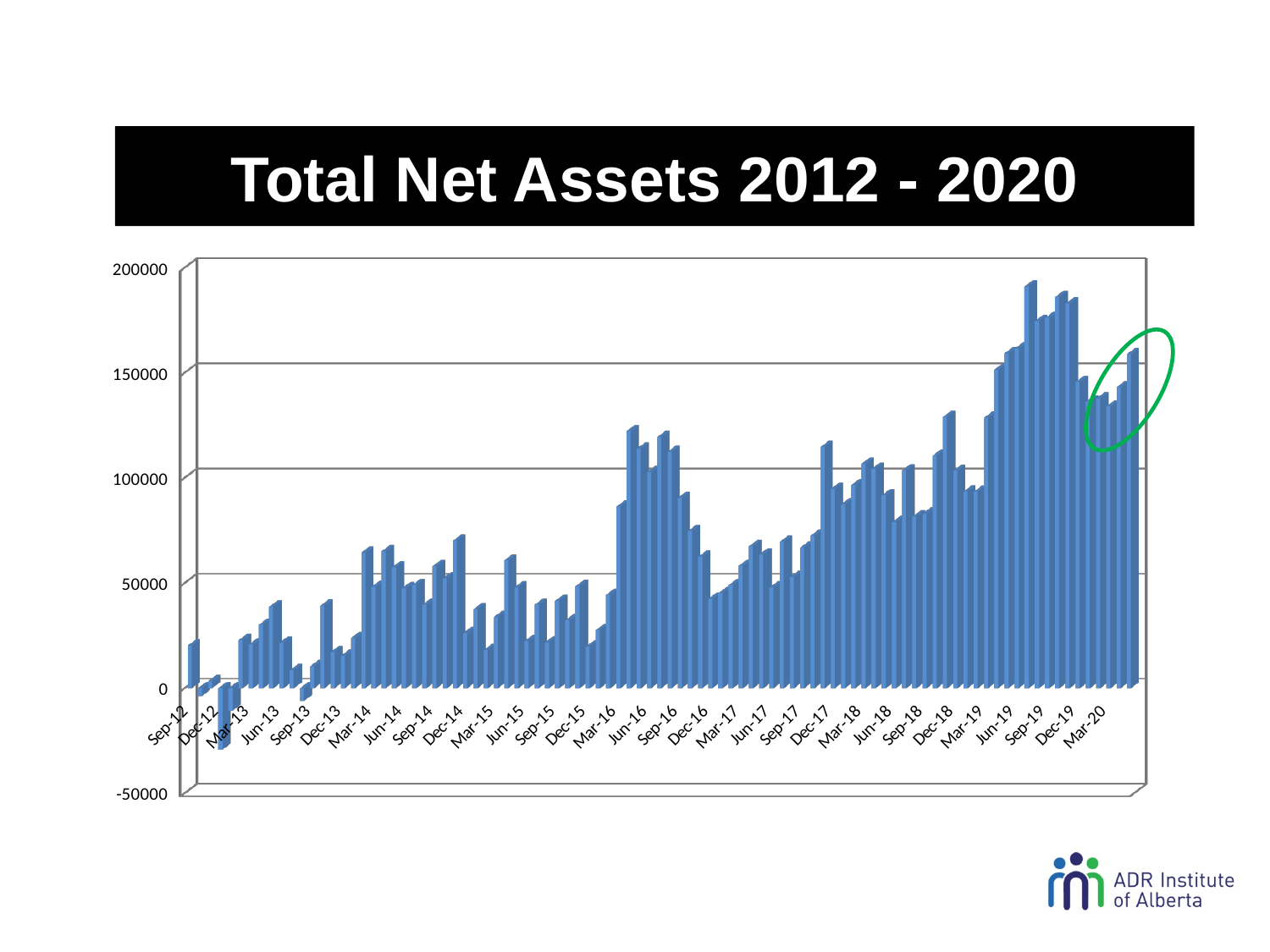
Is the value for Mar-20 greater or less than 150000? less Which is larger, the value for Jun-16 or the value for Jun-13? Jun-16 Is the value for Mar-13 greater or less than 0? greater Is the value for Sep-12 greater or less than 50000? less What is the title of the chart? Total Net Assets 2012 - 2020 Which is larger, the value for Sep-19 or the value for Sep-12? Sep-19 Overall, do the values rise or fall from Sep-12 to 2020? rise What colour are the bars in the chart? blue What kind of chart is shown on the slide? bar chart